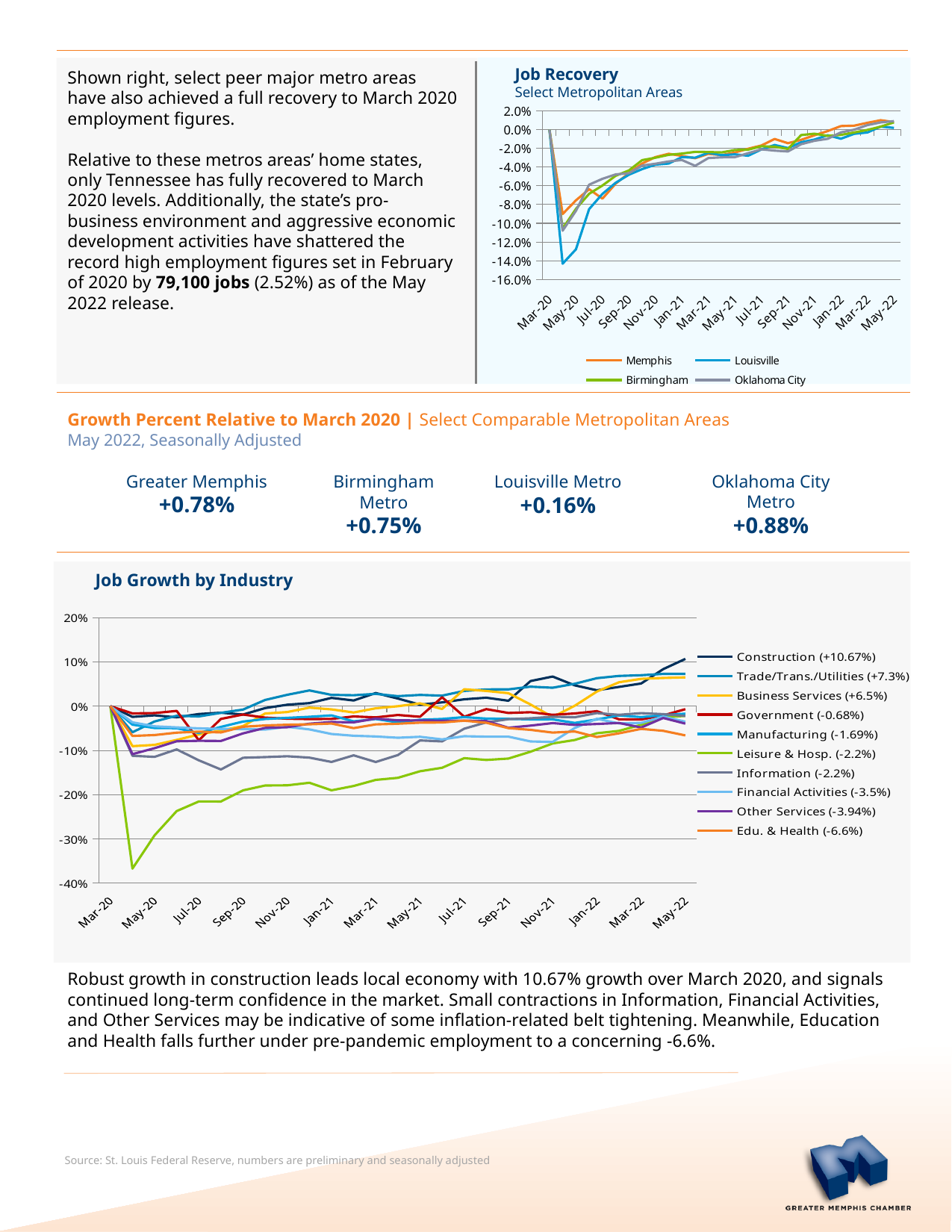
How many series does the legend of the Job Growth by Industry chart list? 10 In the Job Growth by Industry chart, which industry has the lowest growth value in the legend? Edu. & Health How many series does the legend of the Job Recovery chart list? 4 What kind of chart is the Job Recovery chart? line chart In the Job Growth by Industry chart, what is the growth value shown for Construction? +10.67% In the Job Growth by Industry chart, which is larger: the growth value for Business Services or for Trade/Trans./Utilities? Trade/Trans./Utilities In the Job Recovery chart, which metro area has the lowest value in May-20? Louisville In the Job Recovery chart, is the value for Louisville in May-20 greater or less than -12.0%? less In the Job Growth by Industry chart, which industry has the highest growth value in the legend? Construction In the Job Recovery chart, do the values generally rise or fall from May-20 to May-22? rise In the Job Growth by Industry chart, what is the growth value shown for Edu. & Health? -6.6%